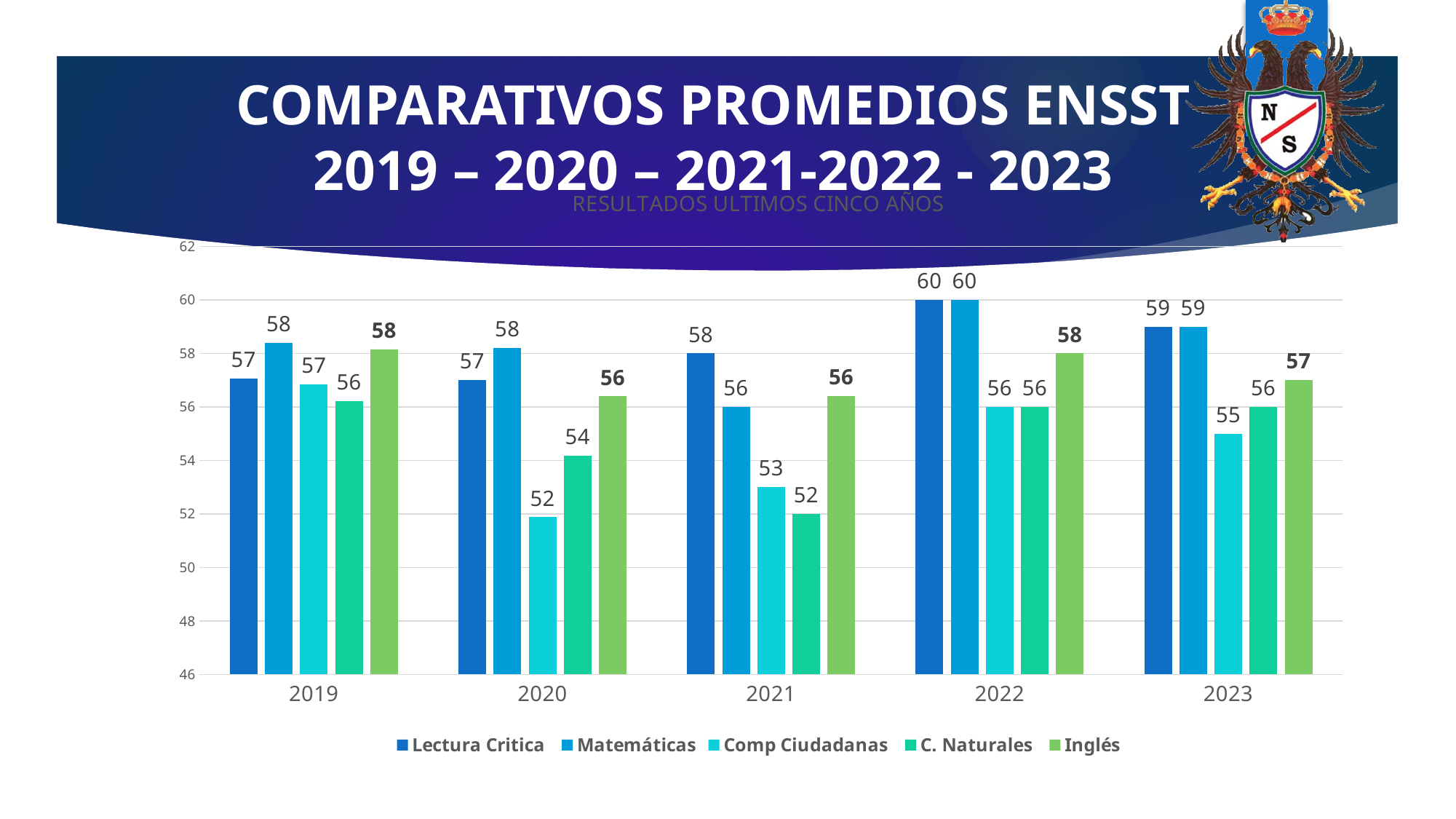
What is the value for Comp Ciudadanas in 2020? 52 How many years are shown on the x axis? 5 Which series has the highest value in 2021? Lectura Critica What is the value for Inglés in 2023? 57 What is the difference between Lectura Critica and Comp Ciudadanas in 2022? 4 How many series does the legend list? 5 Which series has the lowest value in 2020? Comp Ciudadanas What is the value for C. Naturales in 2021? 52 Which series is shown in green in the legend? Inglés What kind of chart is shown on the slide? Bar chart Which is larger in 2023, Comp Ciudadanas or C. Naturales? C. Naturales What is the value for Matemáticas in 2022? 60